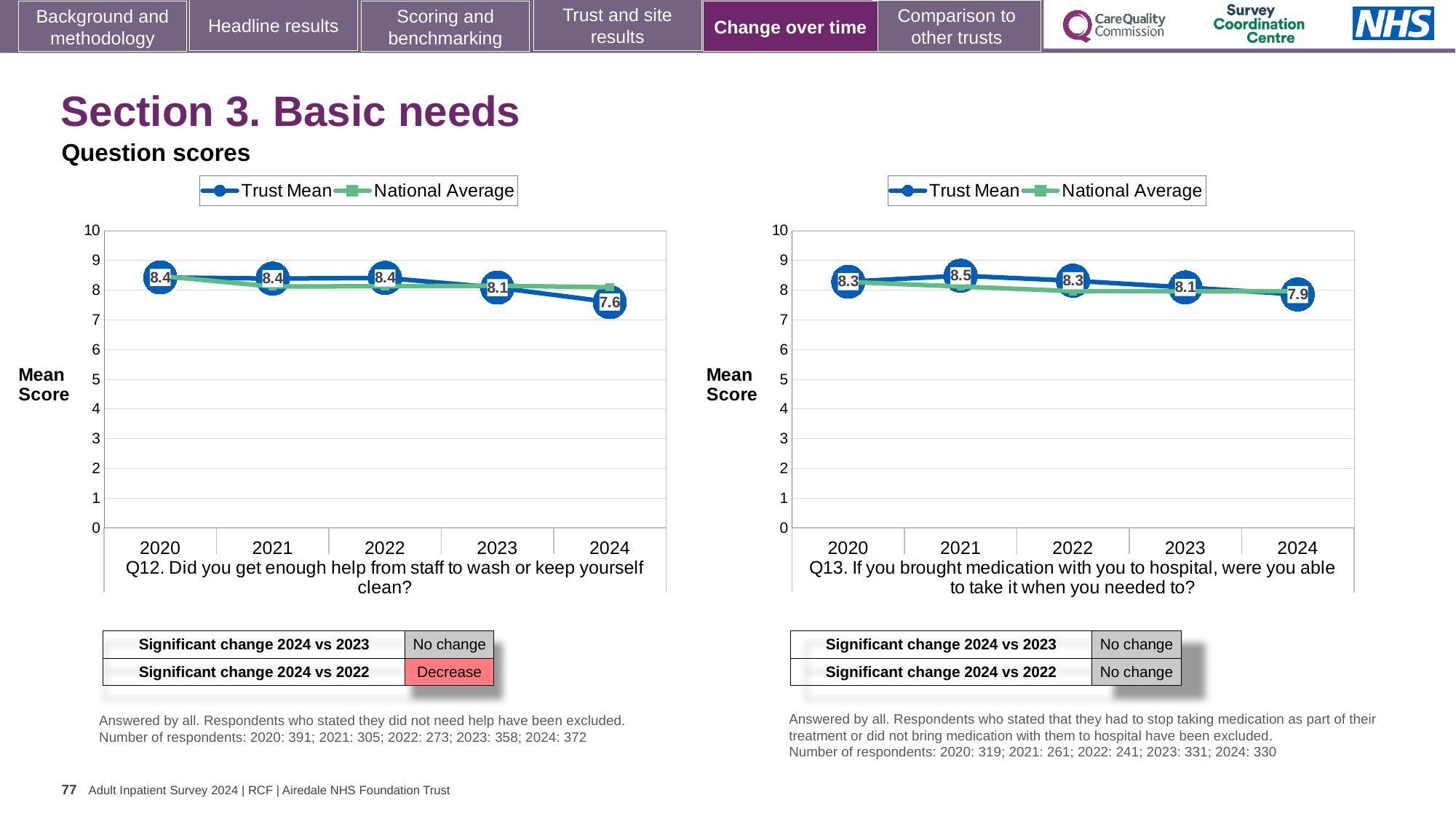
In the Q12 chart (left), does the Trust Mean rise or fall from 2022 to 2024? fall What type of chart is the Q13 chart (right)? line chart In the Q13 chart (right), what is the Trust Mean for 2021? 8.5 In the Q13 chart (right), what is the difference between the Trust Mean in 2021 and in 2024? 0.6 In the Q13 chart (right), is the Trust Mean for 2020 larger or smaller than the Trust Mean for 2023? larger How many series does the legend of the Q12 chart (left) list? 2 In the Q12 chart (left), what is the Trust Mean for 2023? 8.1 In the Q12 chart (left), what is the difference between the Trust Mean in 2022 and in 2024? 0.8 In the Q13 chart (right), which year has the highest Trust Mean? 2021 In the Q13 chart (right), what is the Trust Mean for 2024? 7.9 In the Q12 chart (left), which year has the lowest Trust Mean? 2024 In the Q12 chart (left), what is the Trust Mean for 2024? 7.6